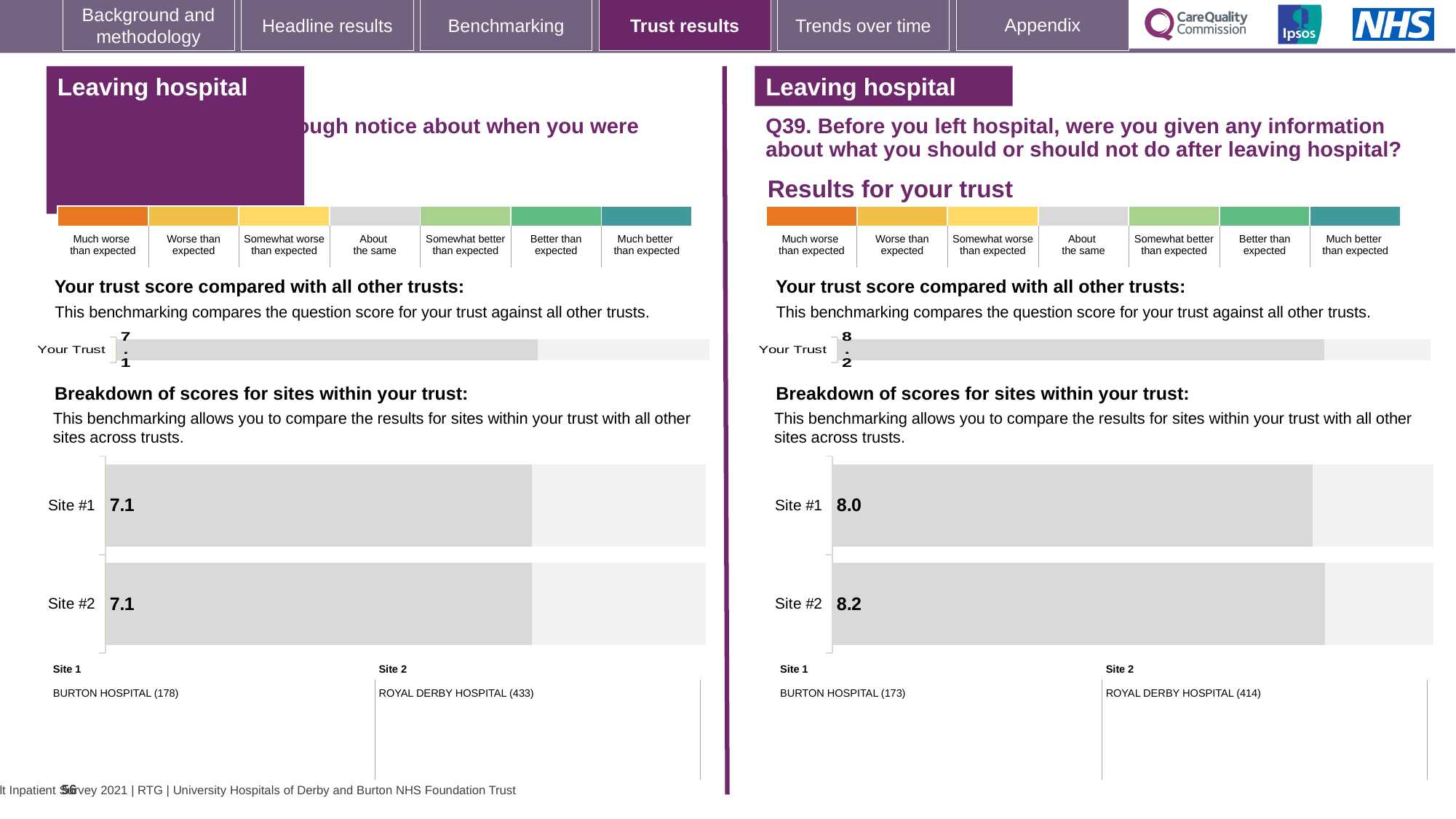
How many sites are shown in the Q39 site breakdown chart on the right? 2 In the Q39 site breakdown chart on the right, which site has the higher score? Site #2 In the left-hand site breakdown chart, which hospital is listed as Site 1? BURTON HOSPITAL (178) In the left-hand 'Breakdown of scores for sites within your trust' chart, what is the score for Site #1? 7.1 In the Q39 site breakdown chart on the right, which hospital is listed as Site 2? ROYAL DERBY HOSPITAL (414) In the left-hand 'Breakdown of scores for sites within your trust' chart, what is the score for Site #2? 7.1 In the Q39 'Breakdown of scores for sites within your trust' chart on the right, what is the score for Site #1? 8.0 What type of chart is used for the site breakdown on the right-hand side of the slide? Bar chart On the right-hand side of the slide (Q39), what is the trust score shown in the 'Your trust score compared with all other trusts' chart? 8.2 In the Q39 'Breakdown of scores for sites within your trust' chart on the right, what is the score for Site #2? 8.2 In the Q39 site breakdown chart on the right, what is the difference between the Site #2 and Site #1 scores? 0.2 On the left-hand side of the slide, what is the trust score shown in the 'Your trust score compared with all other trusts' chart? 7.1